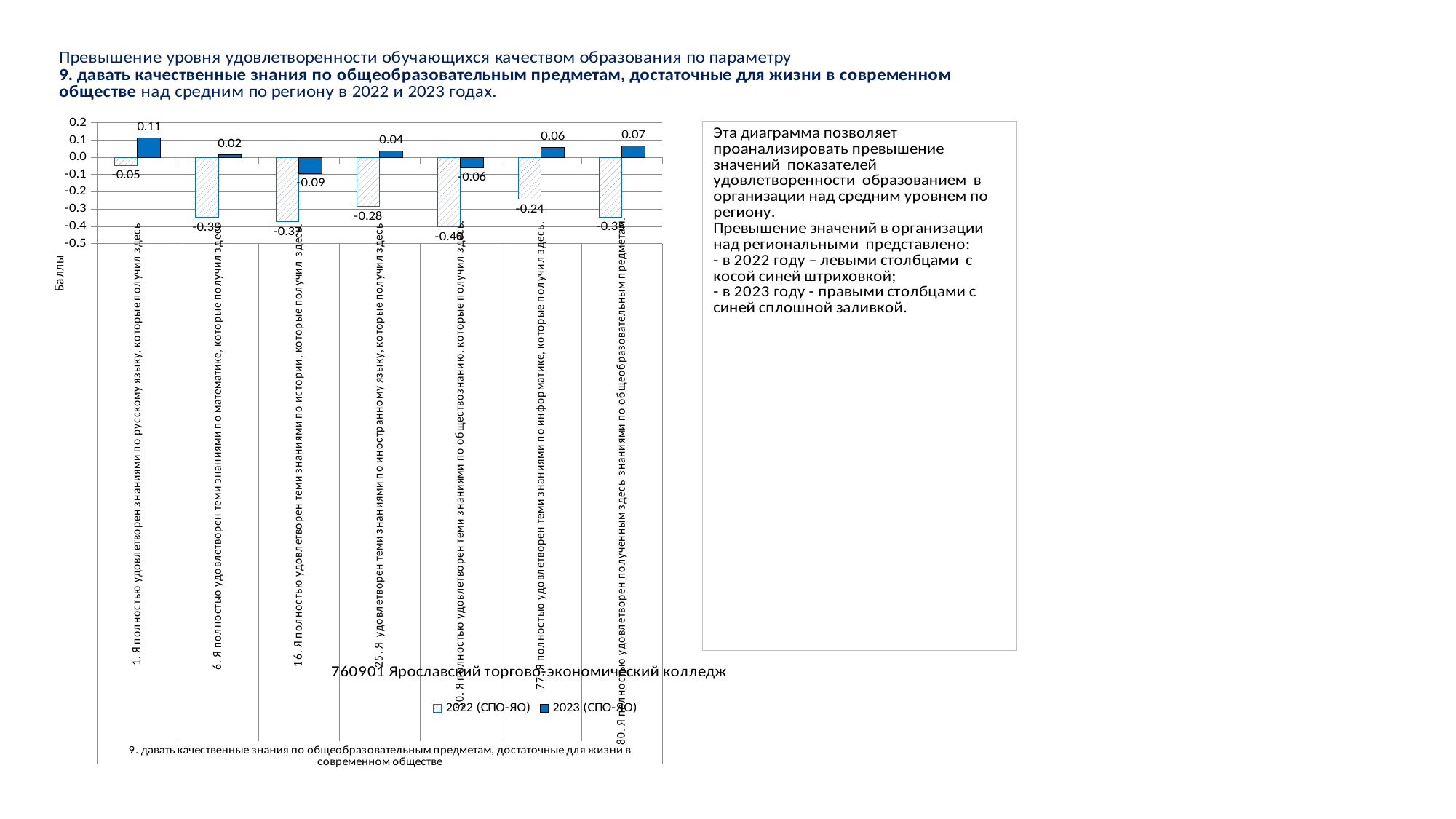
What is the difference between the 2023 and 2022 values for the category about знания по русскому языку (1)? 0.16 What is the 2023 (СПО-ЯО) value for the category "1. Я полностью удовлетворен знаниями по русскому языку, которые получил здесь"? 0.11 What is the 2022 (СПО-ЯО) value for the category about знания по иностранному языку (25)? -0.28 Which category has the lowest 2023 (СПО-ЯО) value? 16. Я полностью удовлетворен теми знаниями по истории, которые получил здесь What is the 2022 (СПО-ЯО) value for the category "1. Я полностью удовлетворен знаниями по русскому языку, которые получил здесь"? -0.05 What is the 2022 (СПО-ЯО) value for the category about знания по информатике (77)? -0.24 What is the 2023 (СПО-ЯО) value for the category about знания по истории (16)? -0.09 How many categories are shown on the x axis? 7 Which category has the highest 2023 (СПО-ЯО) value? 1. Я полностью удовлетворен знаниями по русскому языку, которые получил здесь What kind of chart is shown on the slide? Bar chart How many series does the legend list? 2 What is the 2023 (СПО-ЯО) value for the category about знания по общеобразовательным предметам (80)? 0.07